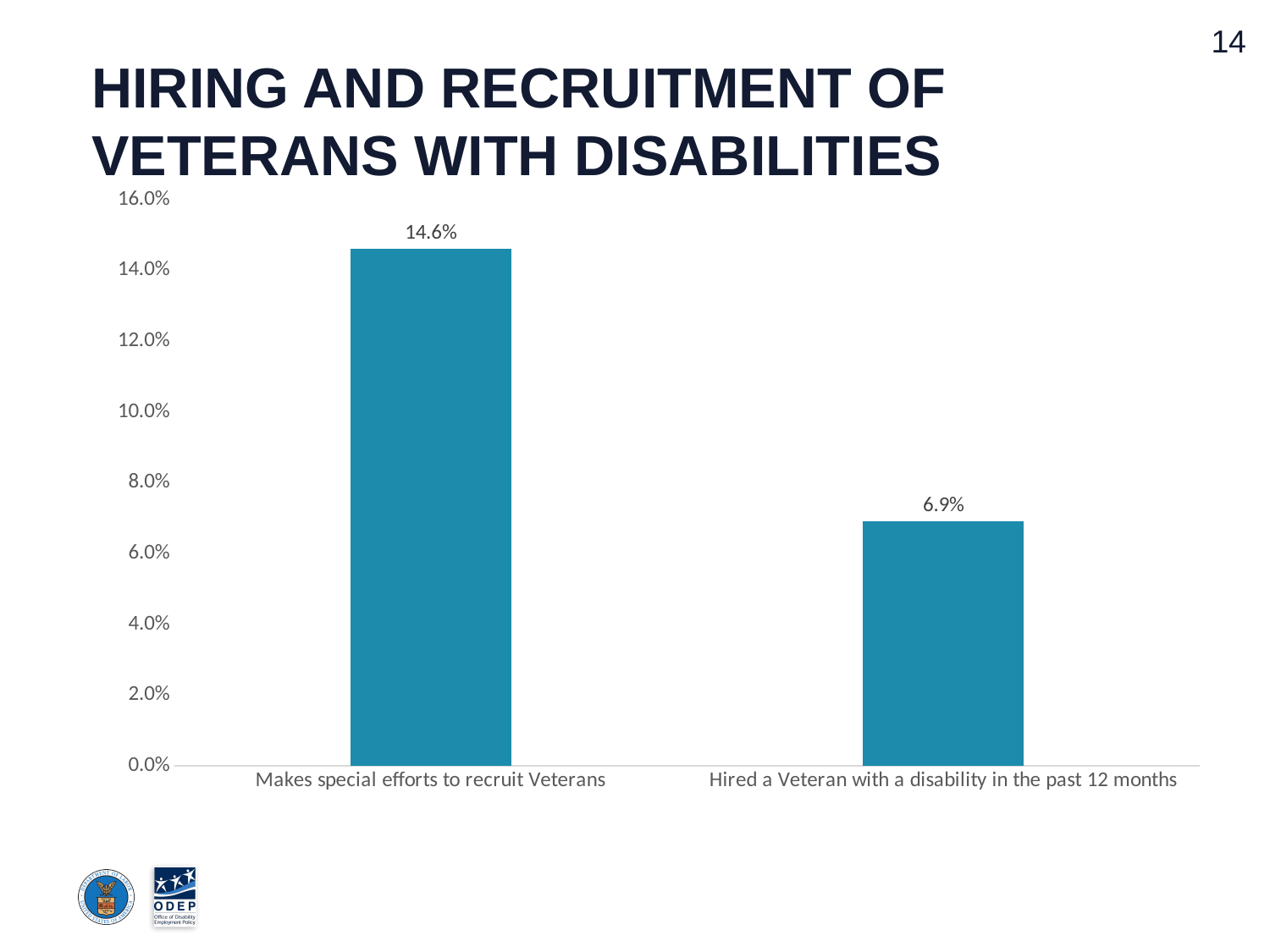
Is the value for "Hired a Veteran with a disability in the past 12 months" greater or less than 8.0%? less What is the value for "Makes special efforts to recruit Veterans"? 14.6% Which category has the lowest value? Hired a Veteran with a disability in the past 12 months Is the value for "Makes special efforts to recruit Veterans" greater or less than 14.0%? greater Which is larger: the value for "Makes special efforts to recruit Veterans" or the value for "Hired a Veteran with a disability in the past 12 months"? Makes special efforts to recruit Veterans What is the title of the slide? HIRING AND RECRUITMENT OF VETERANS WITH DISABILITIES What is the difference between the value for "Makes special efforts to recruit Veterans" and the value for "Hired a Veteran with a disability in the past 12 months"? 7.7% What is the value for "Hired a Veteran with a disability in the past 12 months"? 6.9% What kind of chart is shown on the slide? bar chart How many categories are shown on the chart? 2 What is the maximum value shown on the vertical axis? 16.0% Which category has the highest value? Makes special efforts to recruit Veterans